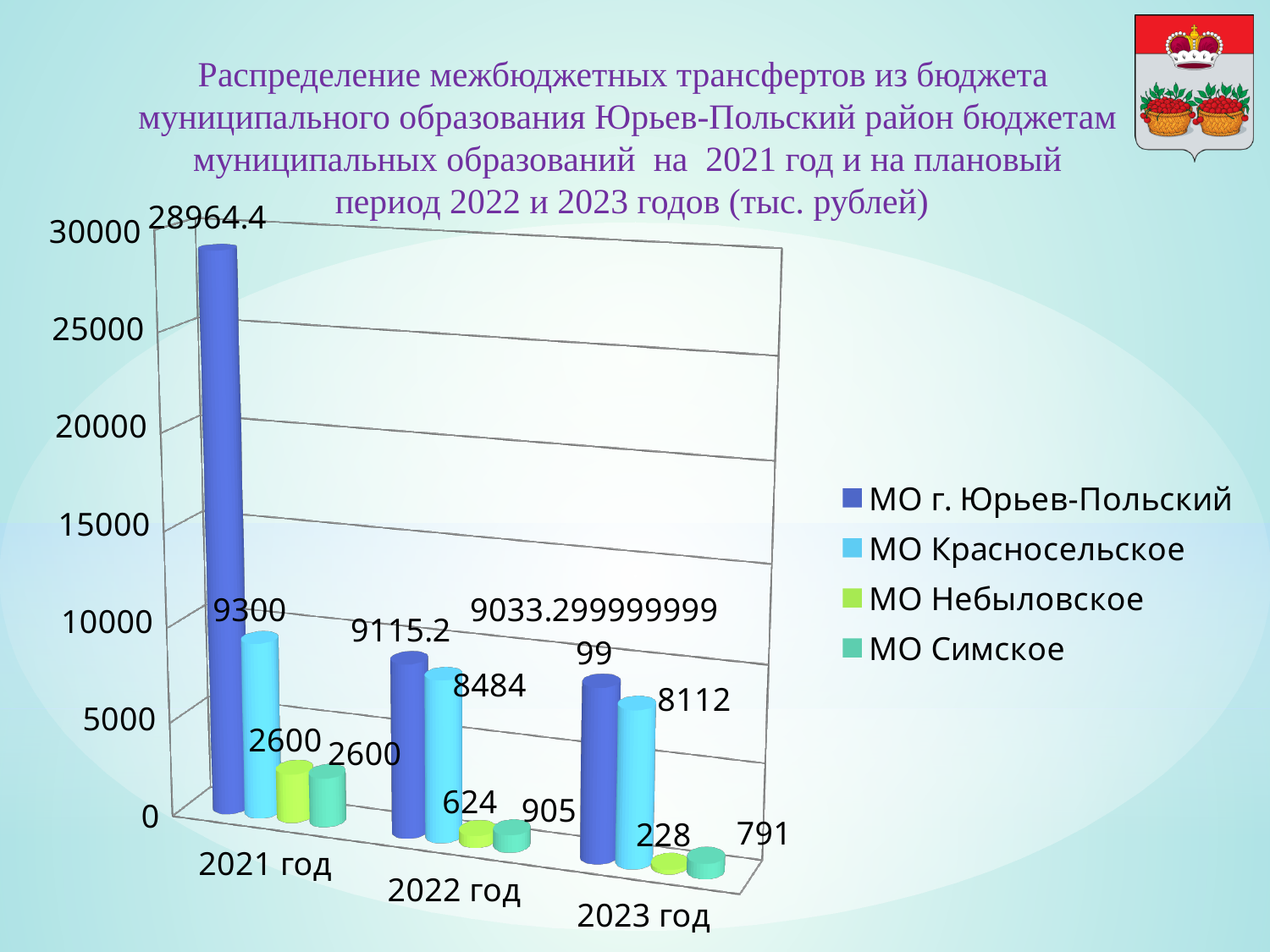
In which year is the value for МО г. Юрьев-Польский the highest? 2021 год In 2022 год, which is larger: the value for МО Небыловское or МО Симское? МО Симское What is the value for МО Красносельское in 2022 год? 8484 What is the difference between the value for МО Красносельское in 2021 год and in 2023 год? 1188 What is the value for МО Небыловское in 2023 год? 228 What is the value for МО Симское in 2022 год? 905 Does the value for МО Красносельское rise or fall from 2021 год to 2023 год? fall How many years are shown on the x axis? 3 Is the value for МО г. Юрьев-Польский in 2021 год greater or less than 25000? greater Which series has the lowest value in 2023 год? МО Небыловское How many series does the legend list? 4 What is the value for МО г. Юрьев-Польский in 2021 год? 28964.4